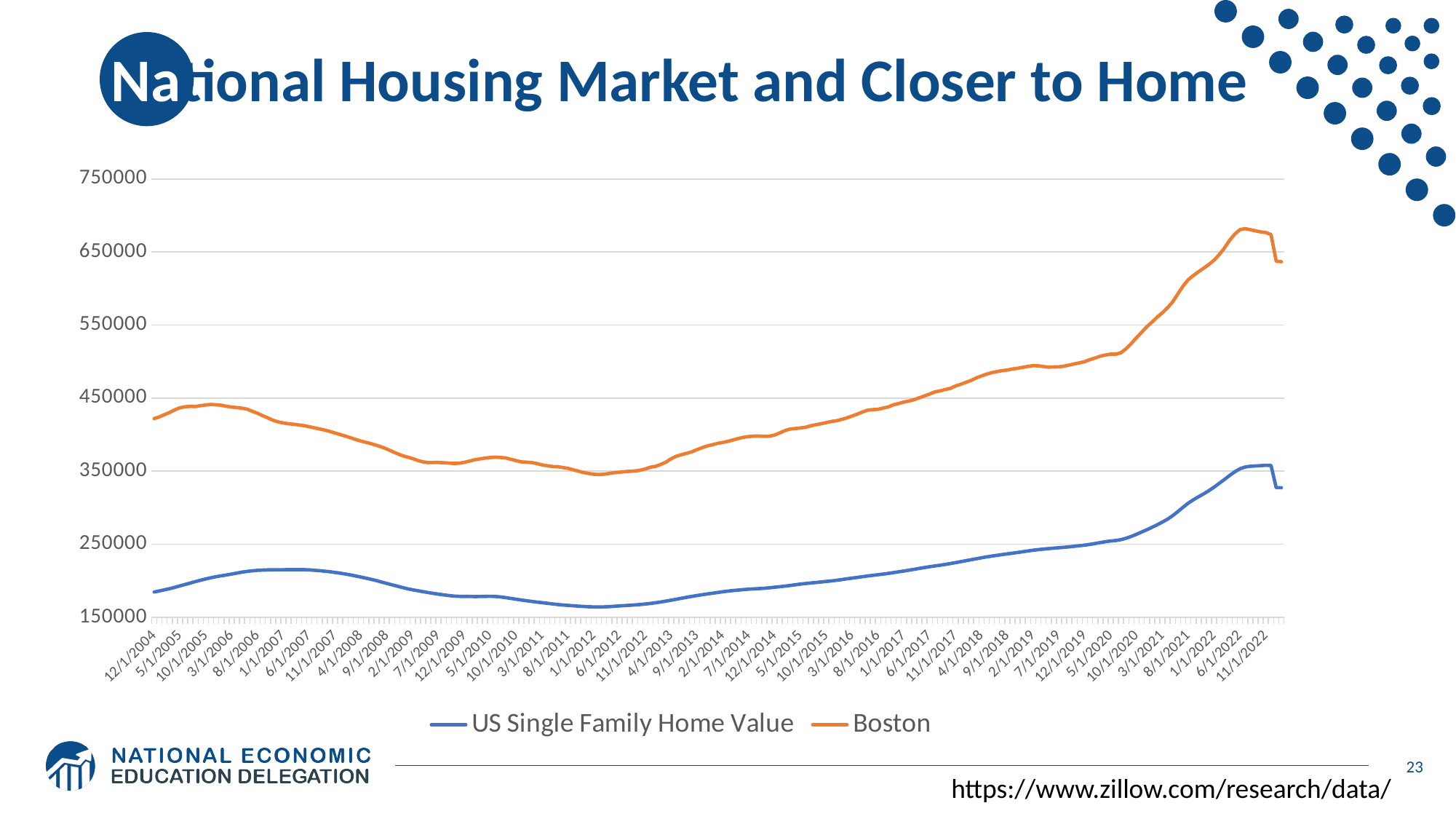
Does the US Single Family Home Value rise or fall between 1/1/2012 and 6/1/2022? rise Is the peak Boston value around 6/1/2022 greater or less than 650000? greater Is the US Single Family Home Value at 12/1/2004 greater or less than 250000? less Which series is shown in orange? Boston Is the US Single Family Home Value at 1/1/2012 greater or less than 250000? less Does the Boston value rise or fall between 3/1/2006 and 1/1/2012? fall What kind of chart is shown on the slide? line chart How many series does the legend list? 2 What is the title of the slide containing the chart? National Housing Market and Closer to Home Which series has higher values throughout the chart, US Single Family Home Value or Boston? Boston